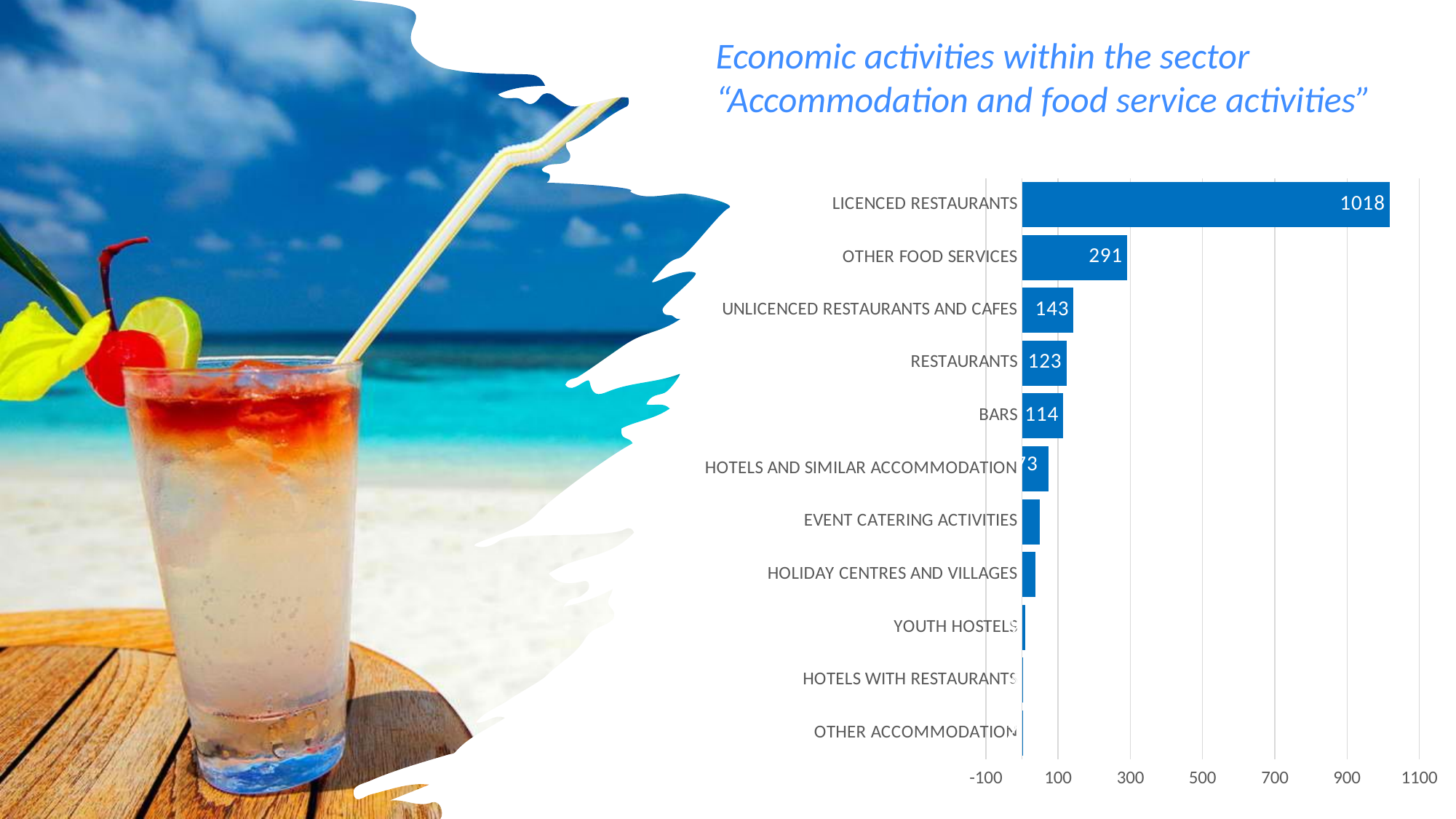
What is the difference between the values for Licenced restaurants and Other food services? 727 What kind of chart is shown on the slide? Bar chart Which sector does the chart title say the economic activities belong to? Accommodation and food service activities What is the value for Licenced restaurants? 1018 What is the difference between the values for Unlicenced restaurants and cafes and Restaurants? 20 Is the value for Event catering activities greater or less than 100? less What is the value for Bars? 114 Which is larger, the value for Restaurants or the value for Bars? Restaurants How many categories are shown in the chart? 11 What is the value for Unlicenced restaurants and cafes? 143 What is the value for Other food services? 291 Which category has the highest value? Licenced restaurants